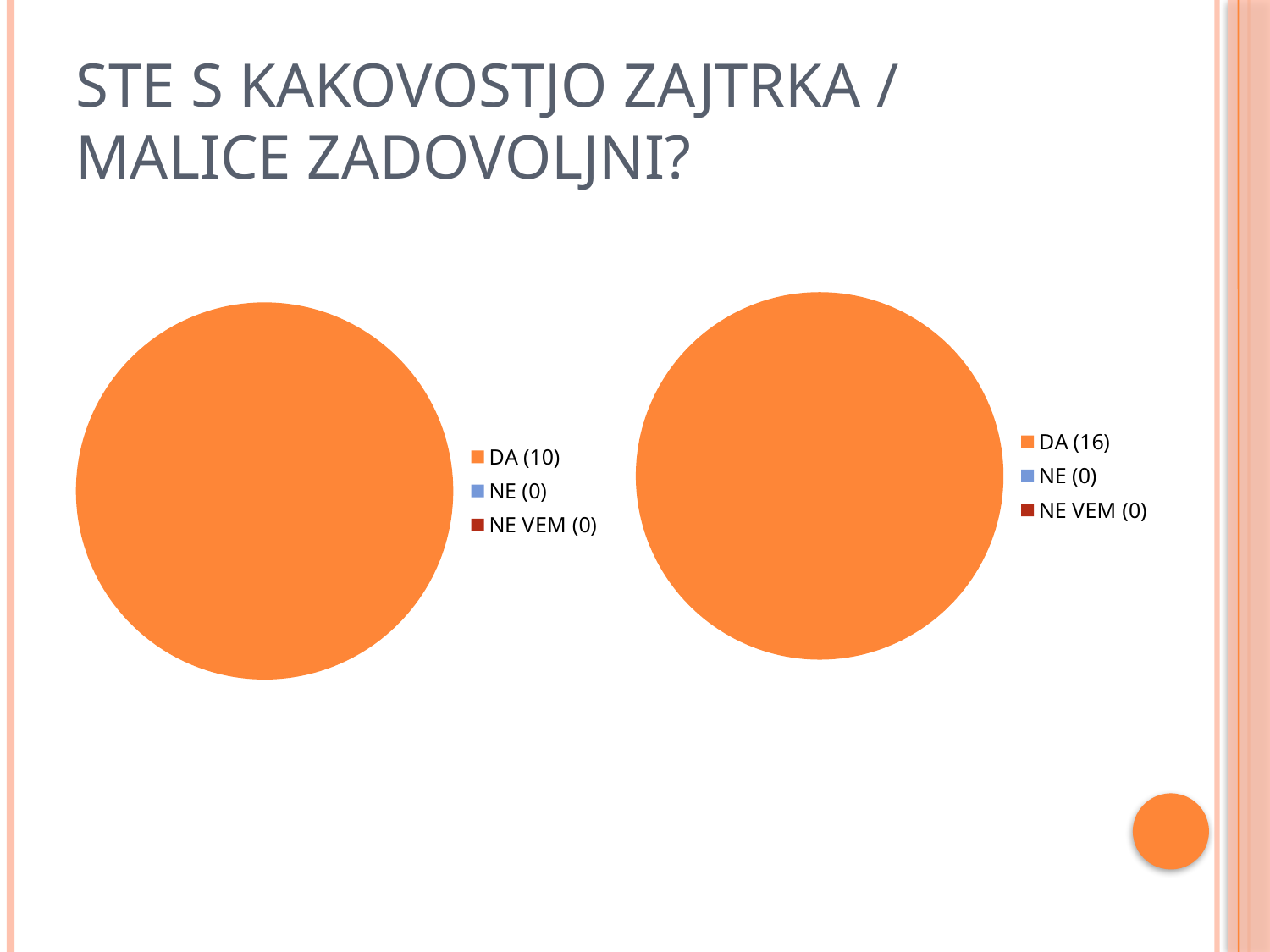
What share of the right pie chart does the DA slice take up? 100% In the right pie chart, what is the value for NE VEM? 0 In the right pie chart, which category has the highest value? DA What kind of chart is the right chart on the slide? pie chart What kind of chart is the left chart on the slide? pie chart How many categories does the legend of the left pie chart list? 3 In the left pie chart, what is the value for NE? 0 Which chart has the larger value for DA, the left pie chart or the right pie chart? the right pie chart In the right pie chart, what is the value for DA? 16 In the left pie chart, which category has the highest value? DA How many categories does the legend of the right pie chart list? 3 In the left pie chart, what is the value for DA? 10